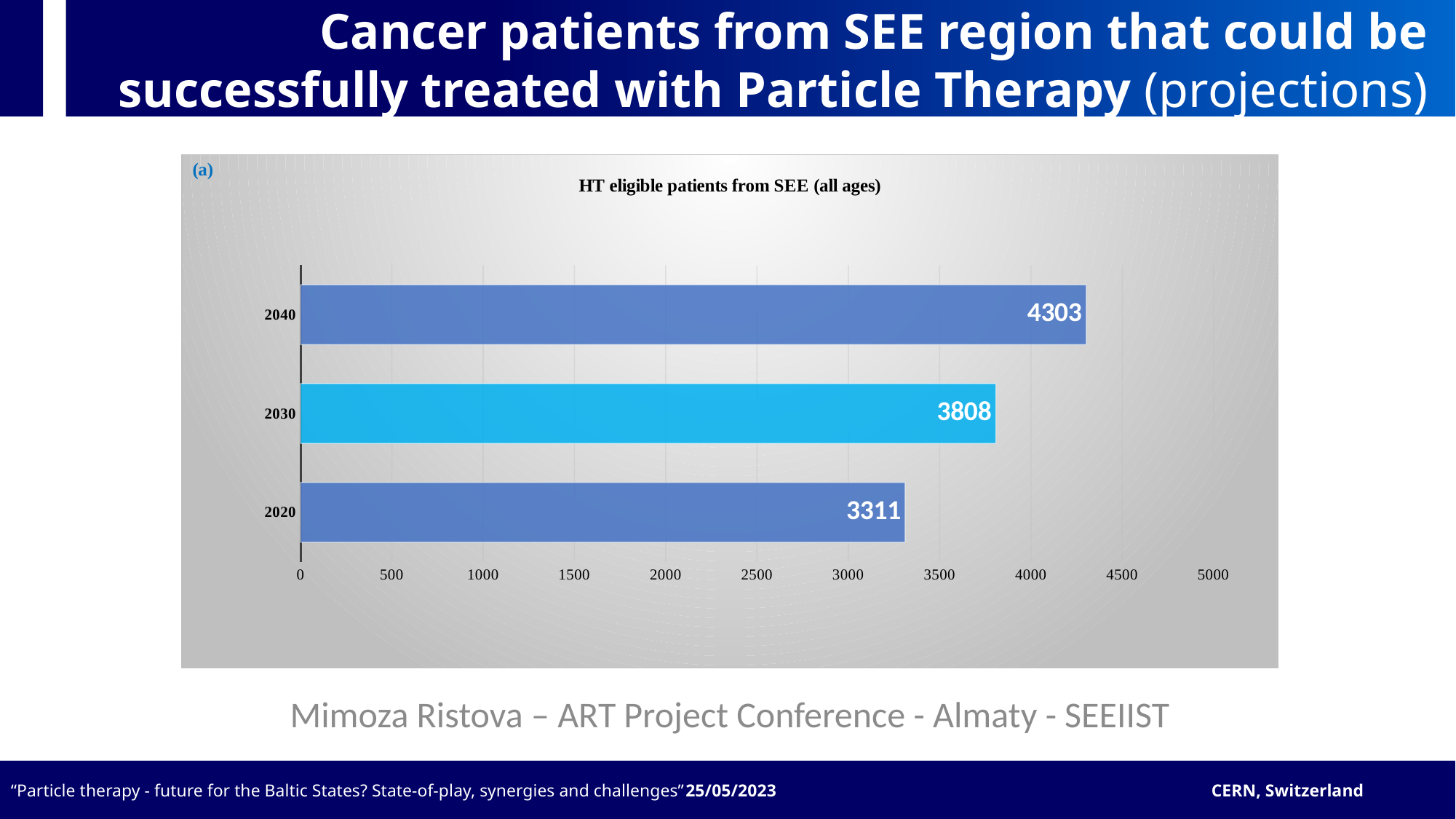
Is the value for 2040 greater or less than 4000? greater What is the title of the chart? HT eligible patients from SEE (all ages) What is the value for 2030? 3808 What is the value for 2020? 3311 Which year has the lowest value? 2020 What kind of chart is shown? bar chart What is the value for 2040? 4303 What is the difference between the values for 2030 and 2020? 497 Which is larger, the value for 2030 or the value for 2020? 2030 What is the difference between the values for 2040 and 2020? 992 How many years are shown in the chart? 3 Which year has the highest value? 2040